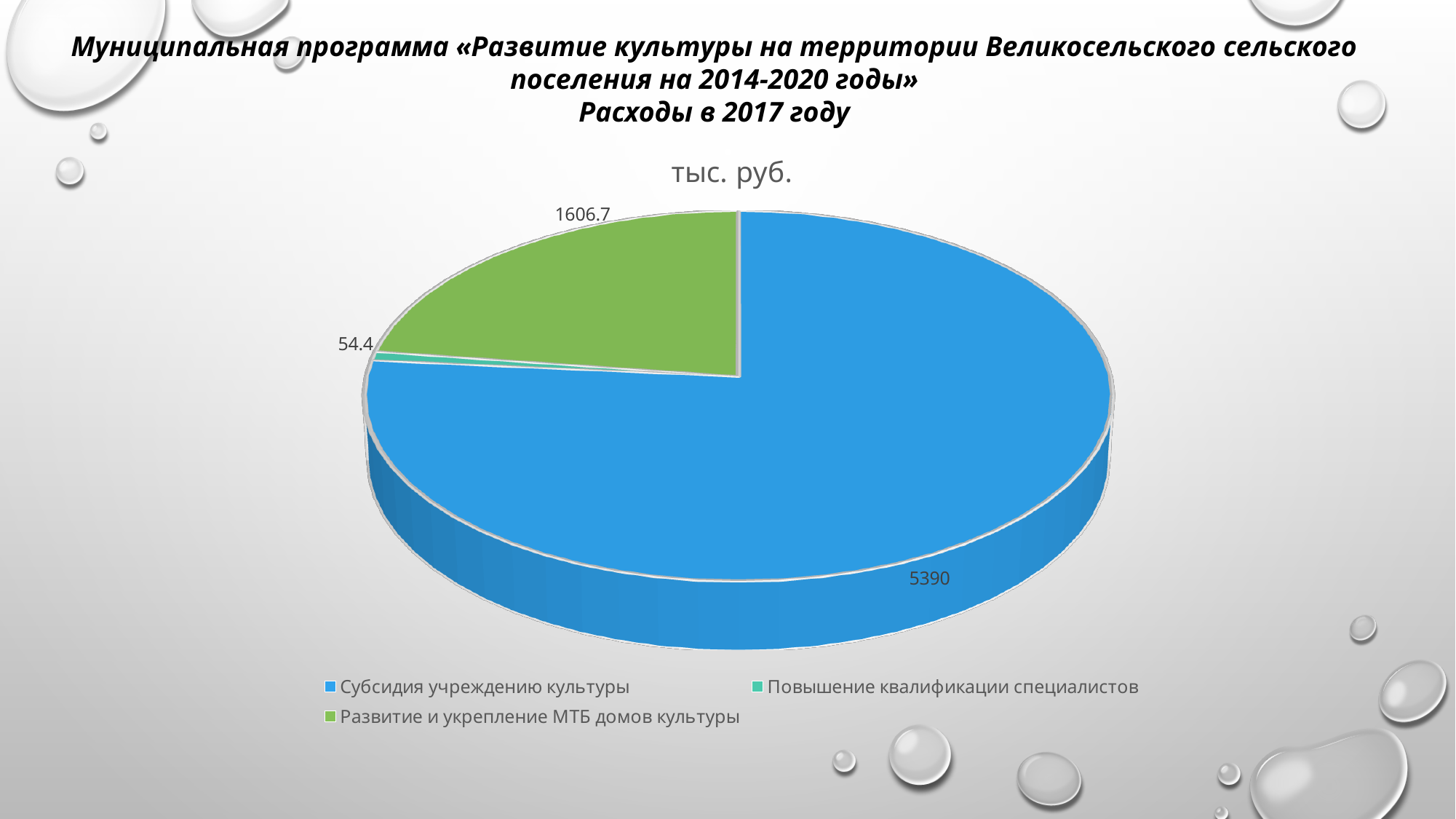
What is the value for Субсидия учреждению культуры? 5390 Which category has the largest slice of the pie? Субсидия учреждению культуры What is the total of all slices in the pie chart? 7051.1 What is the value for Повышение квалификации специалистов? 54.4 Which category has the smallest slice of the pie? Повышение квалификации специалистов What is the difference between the values for Развитие и укрепление МТБ домов культуры and Повышение квалификации специалистов? 1552.3 What type of chart is shown on the slide? Pie chart What is the difference between the values for Субсидия учреждению культуры and Развитие и укрепление МТБ домов культуры? 3783.3 Which is larger: the value for Развитие и укрепление МТБ домов культуры or the value for Повышение квалификации специалистов? Развитие и укрепление МТБ домов культуры What is the title of the chart? тыс. руб. How many categories does the pie chart show? 3 What is the value for Развитие и укрепление МТБ домов культуры? 1606.7